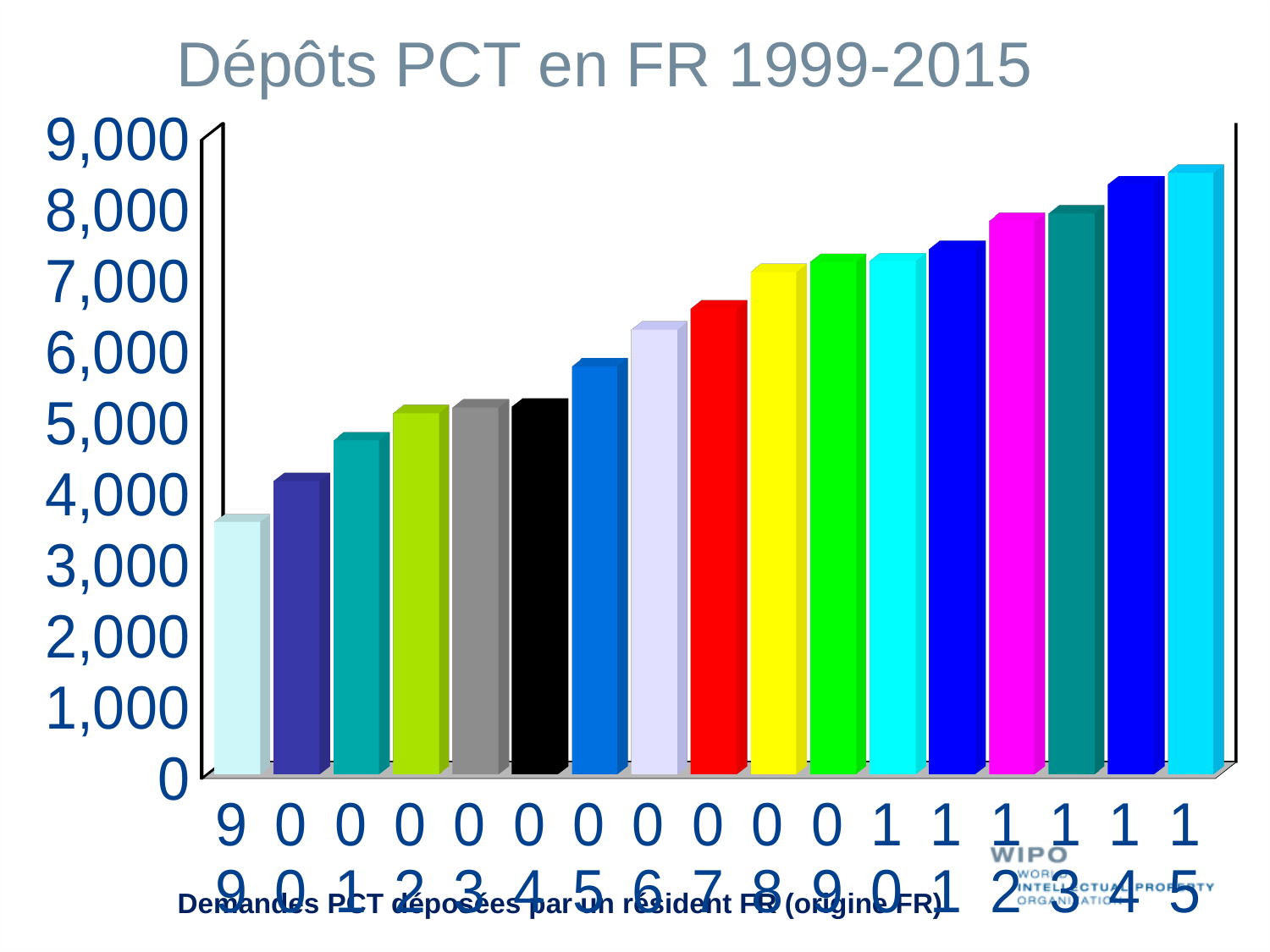
Which is larger, the value for 2005 (05) or the value for 2000 (00)? 2005 (05) Is the value for 2001 (01) greater or less than 5,000? less Is the value for 1999 (99) greater or less than 4,000? less What kind of chart is shown on the slide? bar chart Is the value for 2015 (15) greater or less than 8,000? greater Which is larger, the value for 2003 (03) or the value for 2010 (10)? 2010 (10) Do the values generally rise or fall from 1999 to 2015? rise What label is printed below the x axis of the chart? Demandes PCT déposées par un résident FR (origine FR) How many bars (years) are plotted in the chart? 17 Which year has the lowest value in the chart? 1999 (99) What is the title of the chart? Dépôts PCT en FR 1999-2015